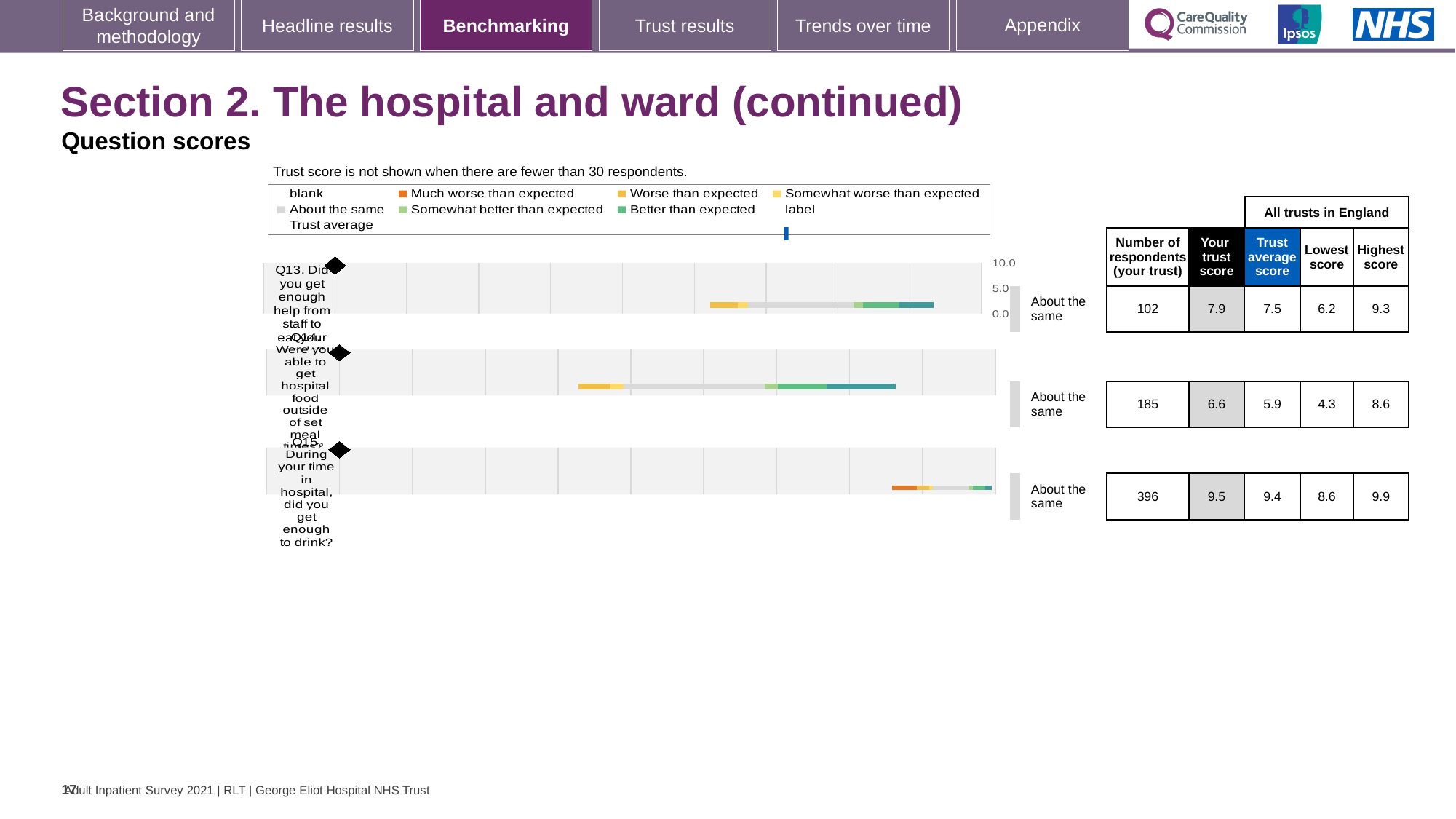
For Q13, what is the difference between the trust score (7.9) and the trust average score (7.5)? 0.4 What kind of chart is used to show the question scores on this slide? bar chart What is the 'Your trust score' value for Q13 (help from staff to eat meals)? 7.9 What is the highest score across all trusts in England for Q15 (enough to drink)? 9.9 How many respondents does the table show for Q14 (hospital food outside of set meal times)? 185 What is the lowest score across all trusts in England for Q14? 4.3 What benchmark category label is shown next to each of the three question bars? About the same Which question has the lowest 'Your trust score'? Q14 Which question has the highest 'Your trust score'? Q15 For Q14, which is larger: the 'Your trust score' or the 'Trust average score'? Your trust score How many survey questions are plotted on the chart? 3 For Q15, what is the difference between the highest score (9.9) and the lowest score (8.6)? 1.3